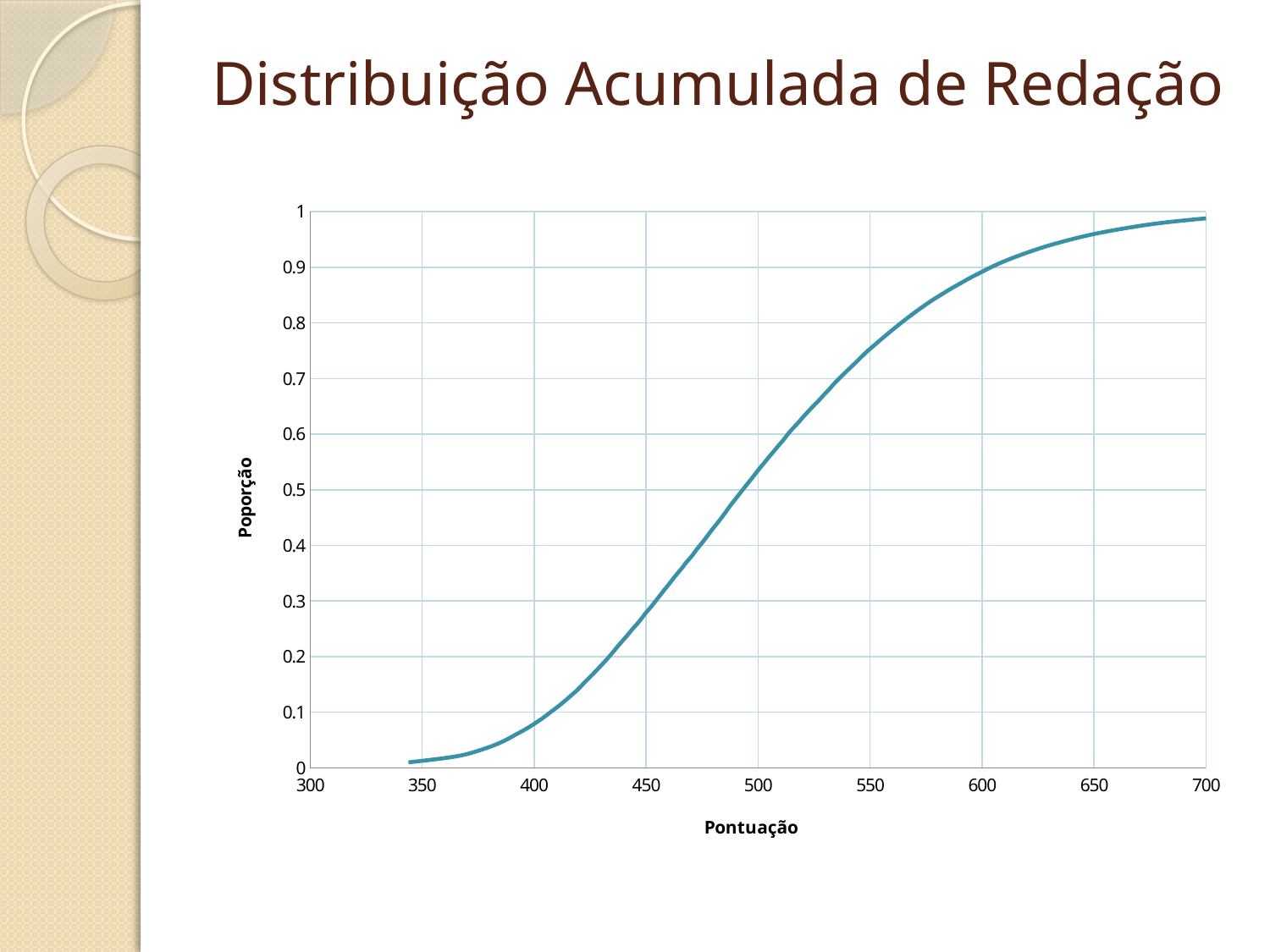
Is the proportion at a score of 500 greater or less than 0.4? greater Is the proportion at a score of 650 greater or less than 0.9? greater What is the label of the horizontal axis of the chart? Pontuação Is the proportion at a score of 450 greater or less than 0.4? less What kind of chart is shown on the slide? line chart Does the plotted proportion rise or fall as the score (Pontuação) increases from 350 to 700? rise What is the title of the chart on the slide? Distribuição Acumulada de Redação